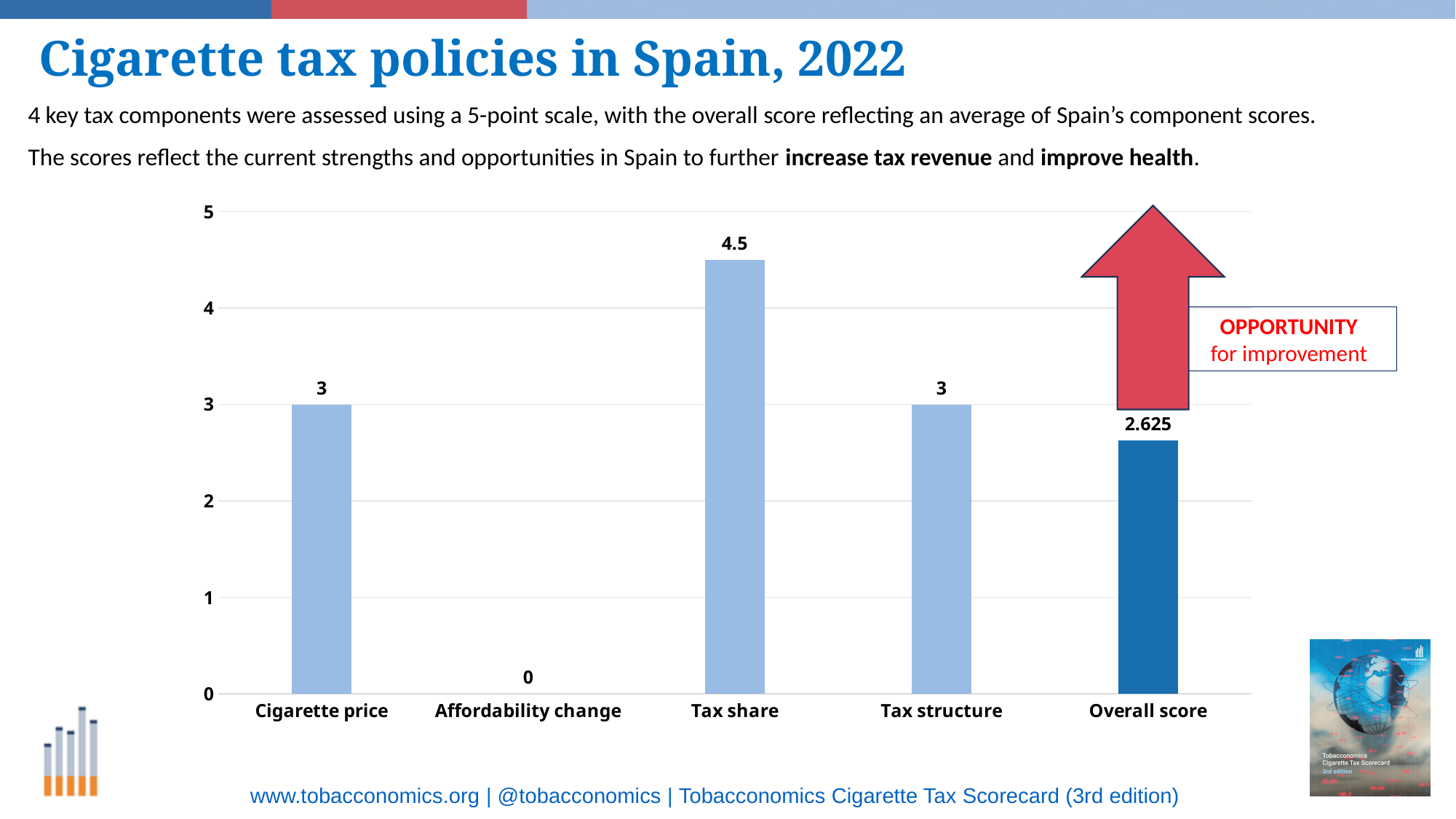
What is the value for Cigarette price? 3 What is the value for Overall score? 2.625 Which category has the lowest value? Affordability change Which category has the highest value? Tax share Is the value for Tax share greater or less than 4? greater How many categories are shown on the x axis? 5 Which is larger, the value for Cigarette price or the value for Overall score? Cigarette price What is the value for Tax share? 4.5 What is the value for Affordability change? 0 What is the difference between the values for Tax share and Tax structure? 1.5 What is the highest value shown on the vertical axis? 5 What kind of chart is shown on the slide? bar chart